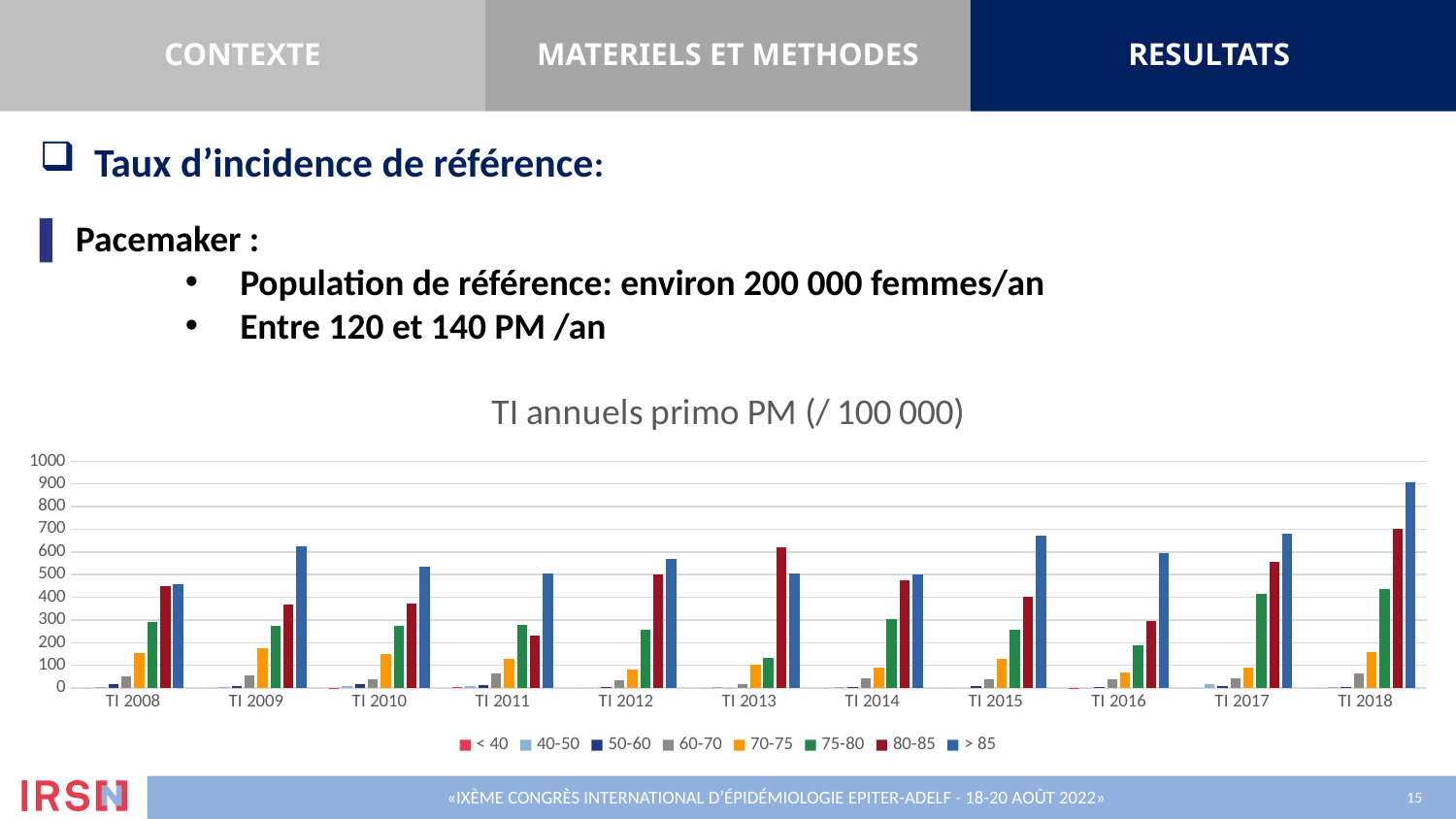
Is the bar for the > 85 age group higher in TI 2018 than in TI 2008? higher In which year is the bar for the > 85 age group the highest? TI 2018 In TI 2018, which is larger: the bar for 80-85 or the bar for > 85? > 85 What is the title of the chart? TI annuels primo PM (/ 100 000) How many series does the chart legend list? 8 What type of chart is shown on the slide? bar chart Is the value for the > 85 age group in TI 2018 greater or less than 800? greater How many years (categories) are shown on the x axis of the chart? 11 Is the value for the 80-85 age group in TI 2013 greater or less than 500? greater Which age group has the highest bar in TI 2013? 80-85 Which age group is shown in the last legend entry? > 85 Is the value for the > 85 age group in TI 2008 greater or less than 500? less